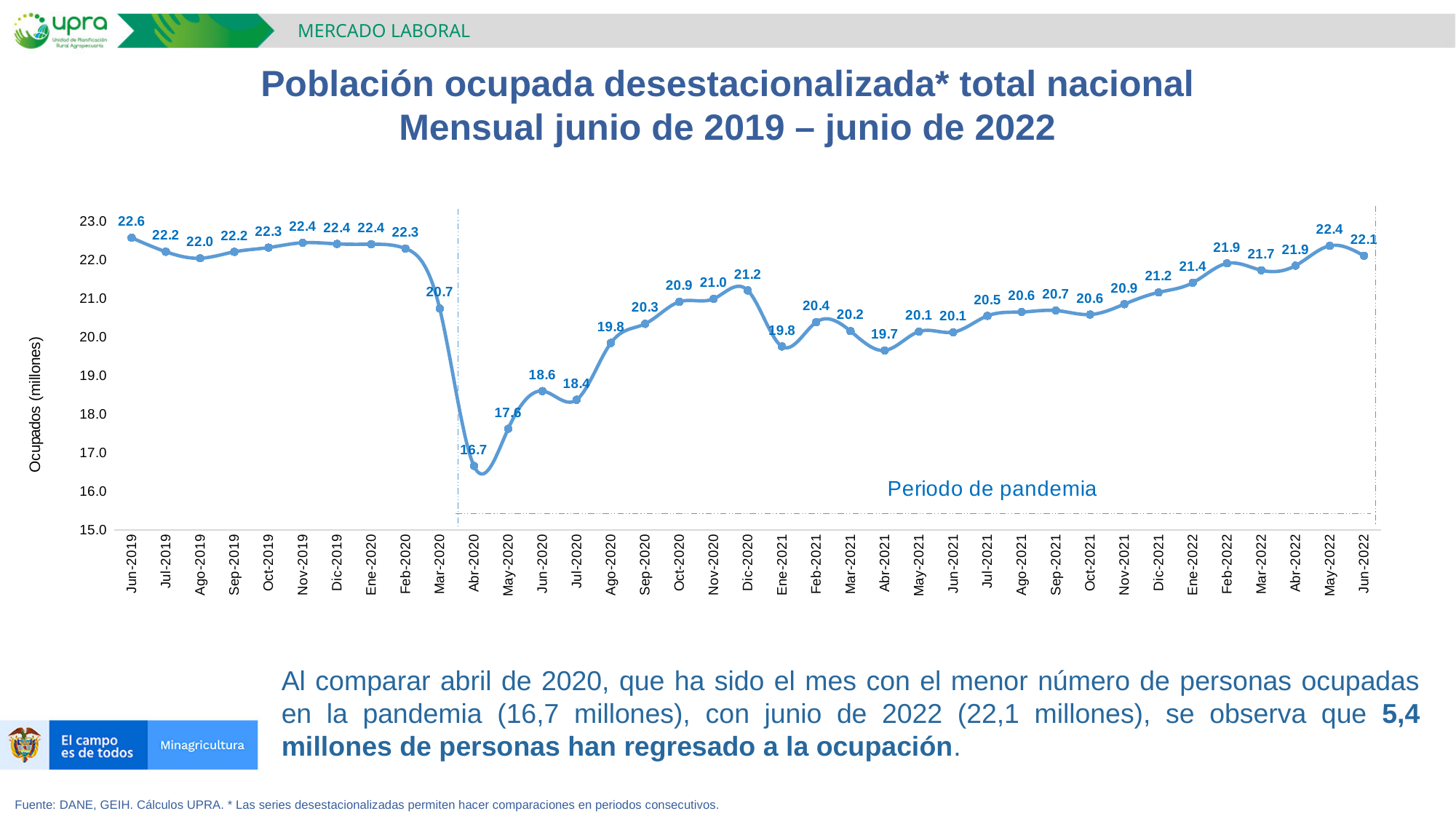
What type of chart is shown on the slide? Line chart What is the value for Dic-2020? 21.2 What is the value for Abr-2020? 16.7 What is the label of the vertical axis? Ocupados (millones) What is the value for Jun-2022? 22.1 Which is larger, the value for May-2022 or the value for Mar-2022? May-2022 Which month has the highest value in the chart? Jun-2019 How many monthly data points are plotted in the chart? 37 Which month has the lowest value in the chart? Abr-2020 What is the difference between the values for Jun-2022 and Abr-2020? 5.4 Do the values rise or fall from Abr-2020 to Dic-2020? Rise Is the value for Jul-2020 greater or less than 19.0? less